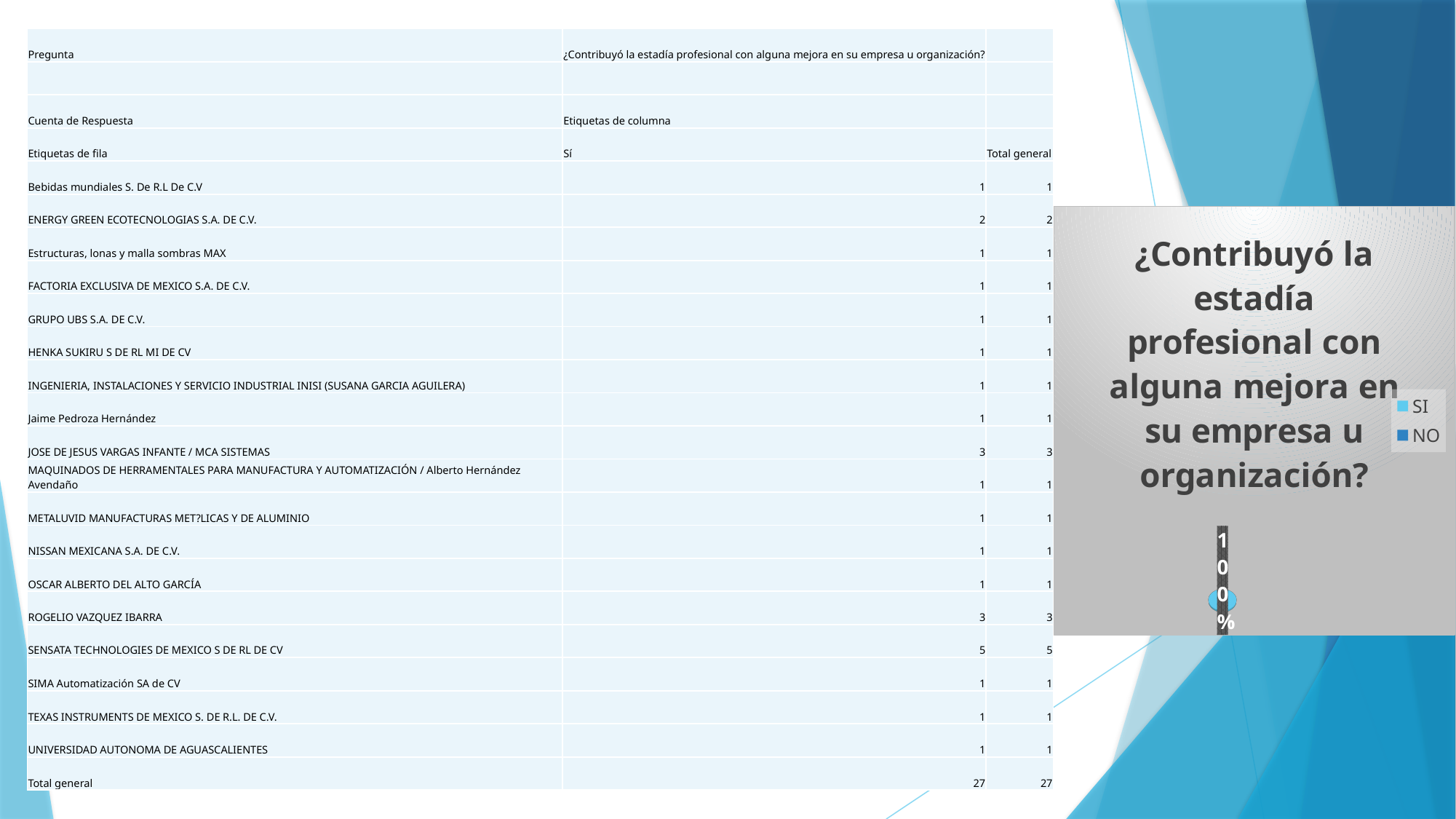
What share of the pie chart does the SI slice represent? 100% Which of the two legend categories, SI or NO, has the larger share in the pie chart? SI What are the two legend entries of the pie chart? SI and NO What kind of chart is shown on the right side of the slide? pie chart What is the title of the pie chart? ¿Contribuyó la estadía profesional con alguna mejora en su empresa u organización? Which category has the largest slice in the pie chart? SI How many entries does the legend of the pie chart list? 2 What value is printed as the data label on the pie chart? 100%